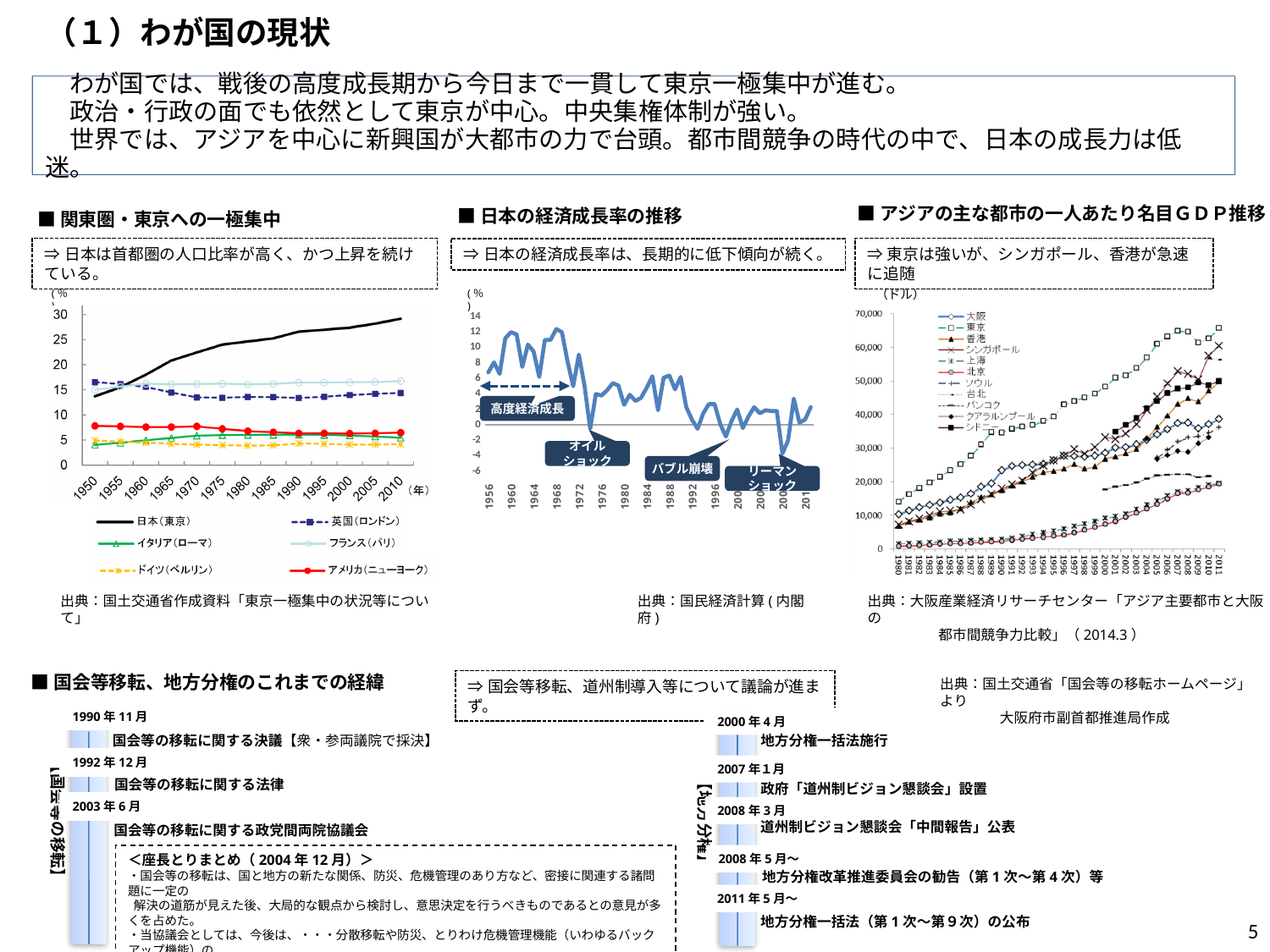
What kind of chart is the left chart titled 関東圏・東京への一極集中? line chart In the right chart titled アジアの主な都市の一人あたり名目GDP推移, is the value for 東京 in 2011 greater or less than 50,000? greater In the left chart titled 関東圏・東京への一極集中, how many series does the legend list? 6 In the right chart titled アジアの主な都市の一人あたり名目GDP推移, how many cities does the legend list? 11 In the left chart titled 関東圏・東京への一極集中, does the 日本(東京) line rise or fall from 1950 to 2010? rise In the left chart titled 関東圏・東京への一極集中, which is larger in 2010: 日本(東京) or アメリカ(ニューヨーク)? 日本(東京) What kind of chart is the middle chart titled 日本の経済成長率の推移? line chart In the middle chart titled 日本の経済成長率の推移, does the growth rate generally rise or fall over the period shown? fall In the left chart titled 関東圏・東京への一極集中, is the value for 日本(東京) in 1950 greater or less than 20? less In the left chart titled 関東圏・東京への一極集中, is the value for 日本(東京) in 2010 greater or less than 25? greater In the middle chart titled 日本の経済成長率の推移, what event label is shown near the sharp drop around 1973? オイルショック In the left chart titled 関東圏・東京への一極集中, which series has the highest value in 2010? 日本(東京)